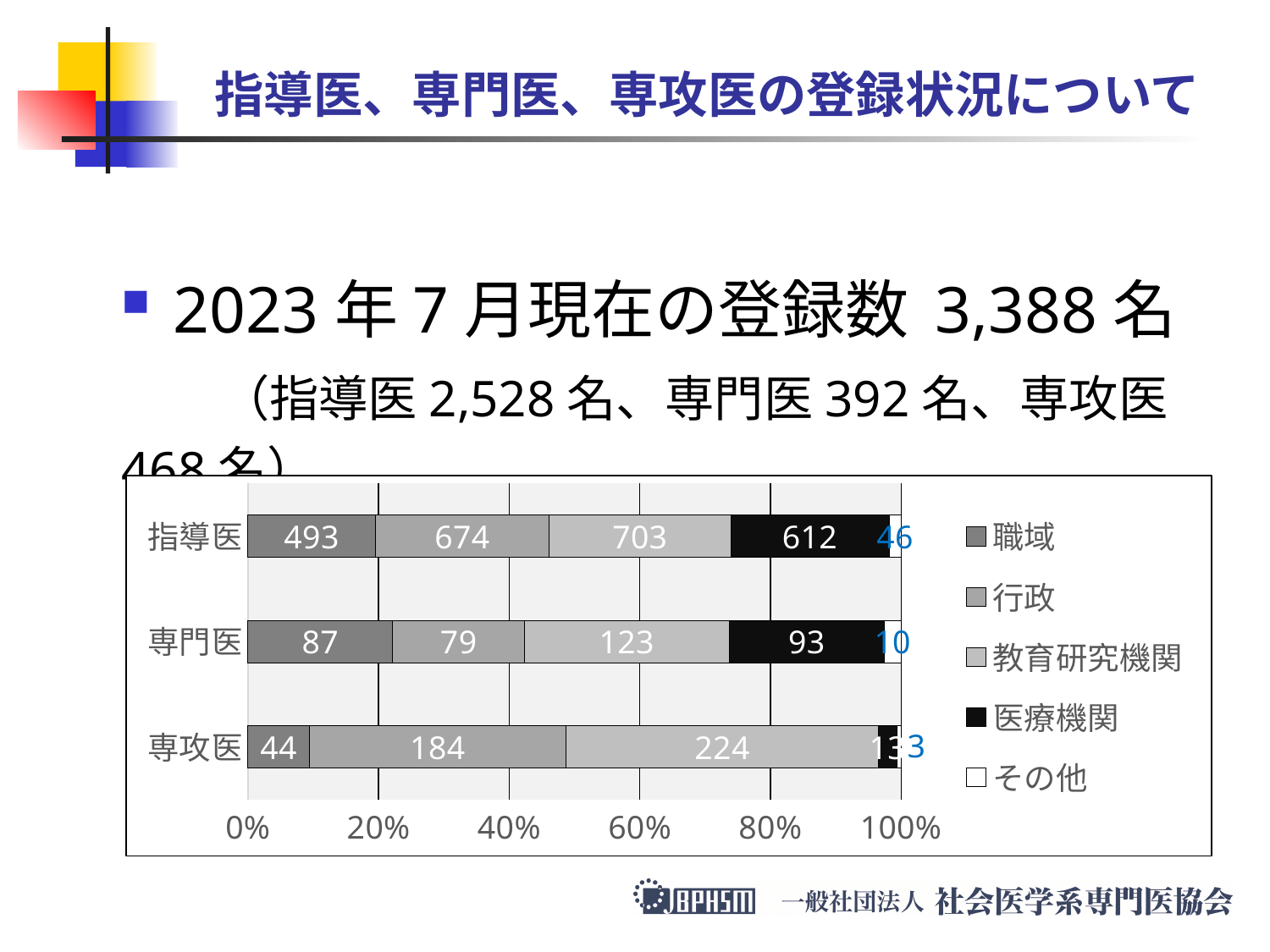
What is the value of 教育研究機関 for 専門医? 123 What is the value of 医療機関 for 指導医? 612 How many series does the legend list? 5 What is the value of 行政 for 専攻医? 184 What is the value of 職域 for 指導医? 493 What is the value of その他 for 専門医? 10 Which series has the lowest value for 専門医? その他 What kind of chart is shown on the slide? Stacked bar chart Which is larger for 専門医: 職域 or 行政? 職域 What is the difference between 行政 and 職域 for 指導医? 181 Which series has the highest value for 指導医? 教育研究機関 How many categories are plotted on the vertical axis? 3